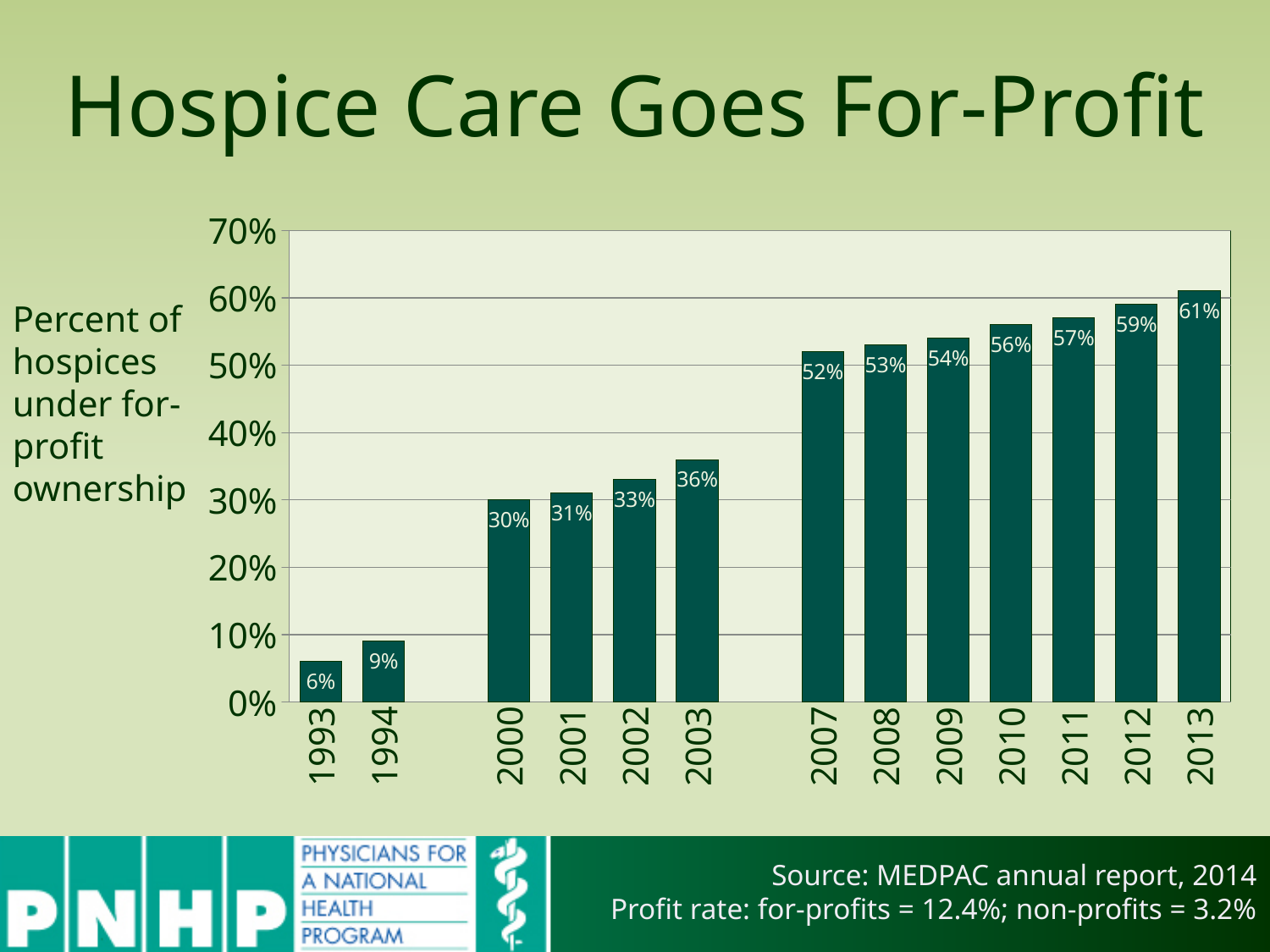
How many years are shown on the x axis? 13 What is the difference between the values for 2007 and 2003? 16% What is the difference between the values for 2013 and 1993? 55% What percent of hospices were under for-profit ownership in 1993? 6% Do the values rise or fall from 1993 to 2013? Rise Which year has the lowest percent of hospices under for-profit ownership? 1993 What is the value shown for 2013? 61% Which year has the highest percent of hospices under for-profit ownership? 2013 Is the value for 2012 greater or less than 50%? greater Which is larger, the value for 2000 or the value for 2009? 2009 What kind of chart is shown on the slide? Bar chart What is the value shown for 2003? 36%